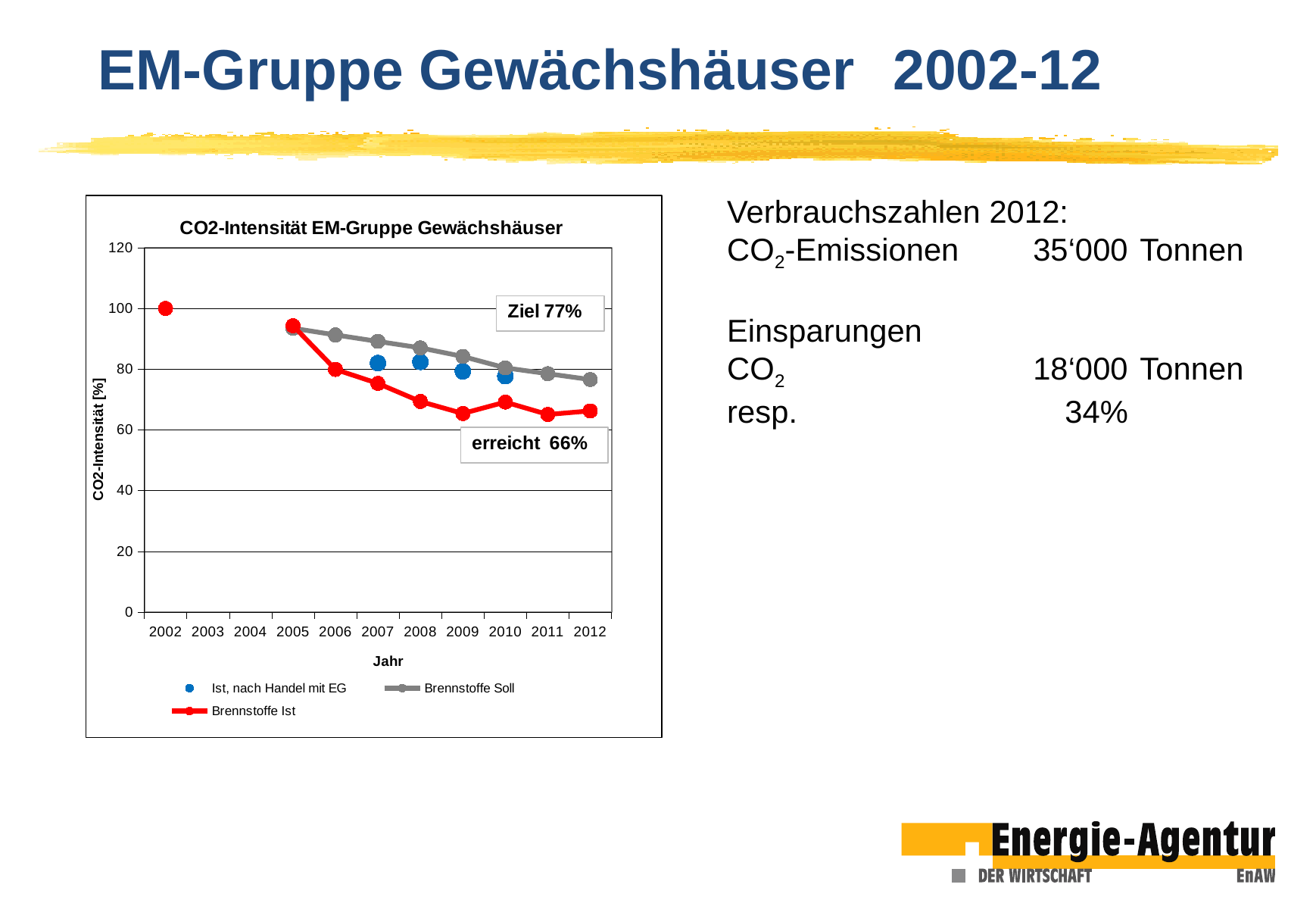
In which year is the Brennstoffe Ist series at its highest? 2002 How many series does the chart legend list? 3 What is the label of the y axis of the chart? CO2-Intensität [%] In 2008, which is larger: Brennstoffe Soll or Brennstoffe Ist? Brennstoffe Soll What target value (Ziel) is annotated on the chart? 77% Is the value of Brennstoffe Ist in 2009 greater or less than 80? less What is the value of the Brennstoffe Ist series in 2002? 100 Does the Brennstoffe Soll series rise or fall from 2005 to 2012? fall How many years are labelled on the x axis of the chart? 11 What kind of chart is shown on the slide? line chart Is the value of Brennstoffe Soll in 2006 greater or less than 80? greater What is the title of the chart? CO2-Intensität EM-Gruppe Gewächshäuser